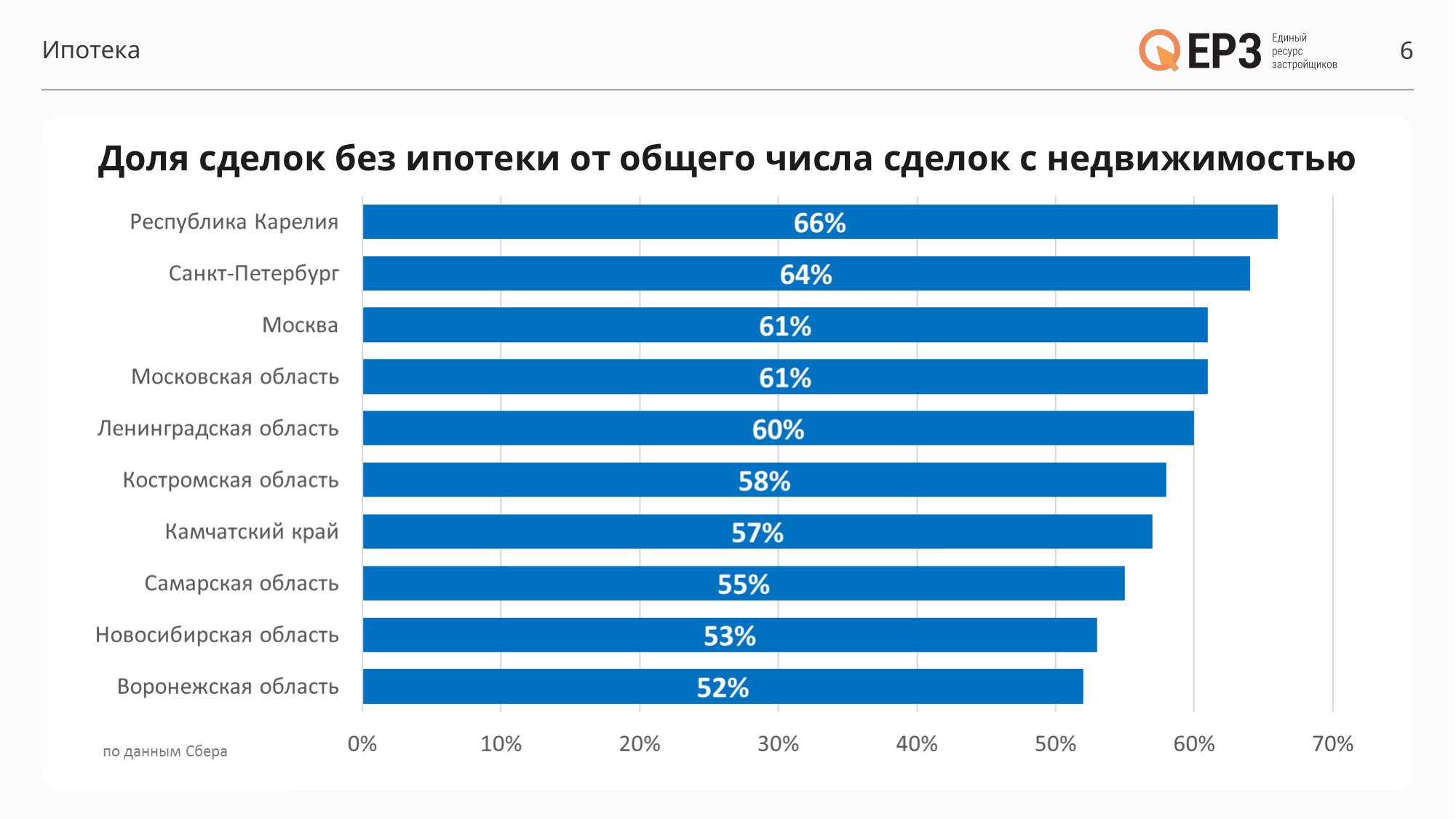
Which region has the lowest share of deals without a mortgage? Воронежская область What is the value for Санкт-Петербург? 64% What is the title of the chart? Доля сделок без ипотеки от общего числа сделок с недвижимостью What is the difference between the values for Республика Карелия and Воронежская область? 14% What is the value for Воронежская область? 52% What is the value for Костромская область? 58% Is the value for Новосибирская область greater or less than 50%? greater What is the value for Республика Карелия? 66% Which is larger, the value for Камчатский край or the value for Самарская область? Камчатский край What kind of chart is shown on the slide? bar chart Which region has the highest share of deals without a mortgage? Республика Карелия How many regions are shown in the chart? 10